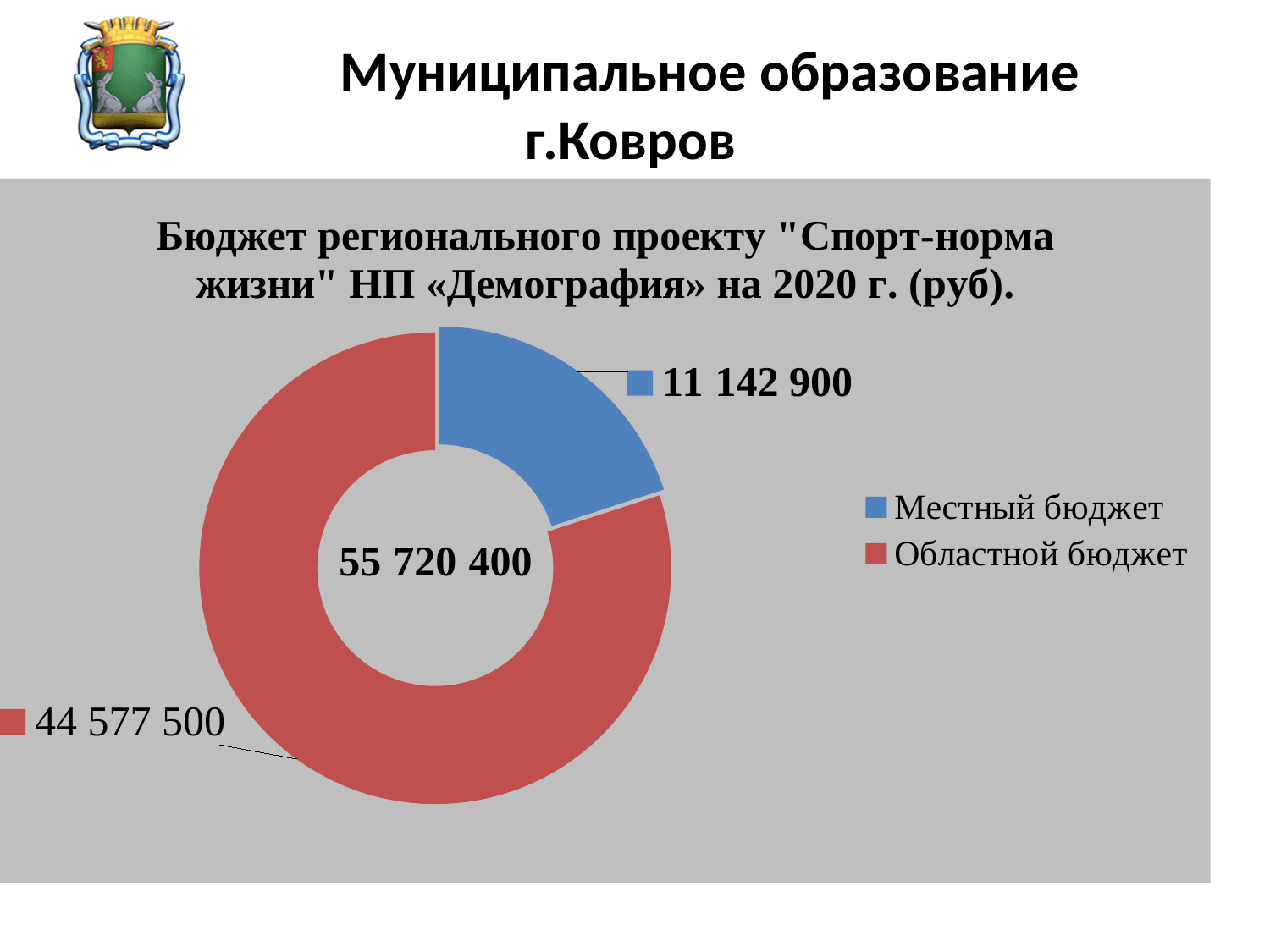
What kind of chart is shown on the slide? Doughnut chart What colour represents Местный бюджет in the chart? Blue Which is larger, Местный бюджет or Областной бюджет? Областной бюджет How many entries does the legend list? 2 What year does the chart title refer to? 2020 What is the value for Местный бюджет? 11 142 900 How many categories does the chart show? 2 Which budget source has the smallest share of the chart? Местный бюджет What is the total budget shown in the centre of the chart? 55 720 400 What is the value for Областной бюджет? 44 577 500 Which budget source has the largest share of the chart? Областной бюджет What is the difference between Областной бюджет and Местный бюджет? 33 434 600